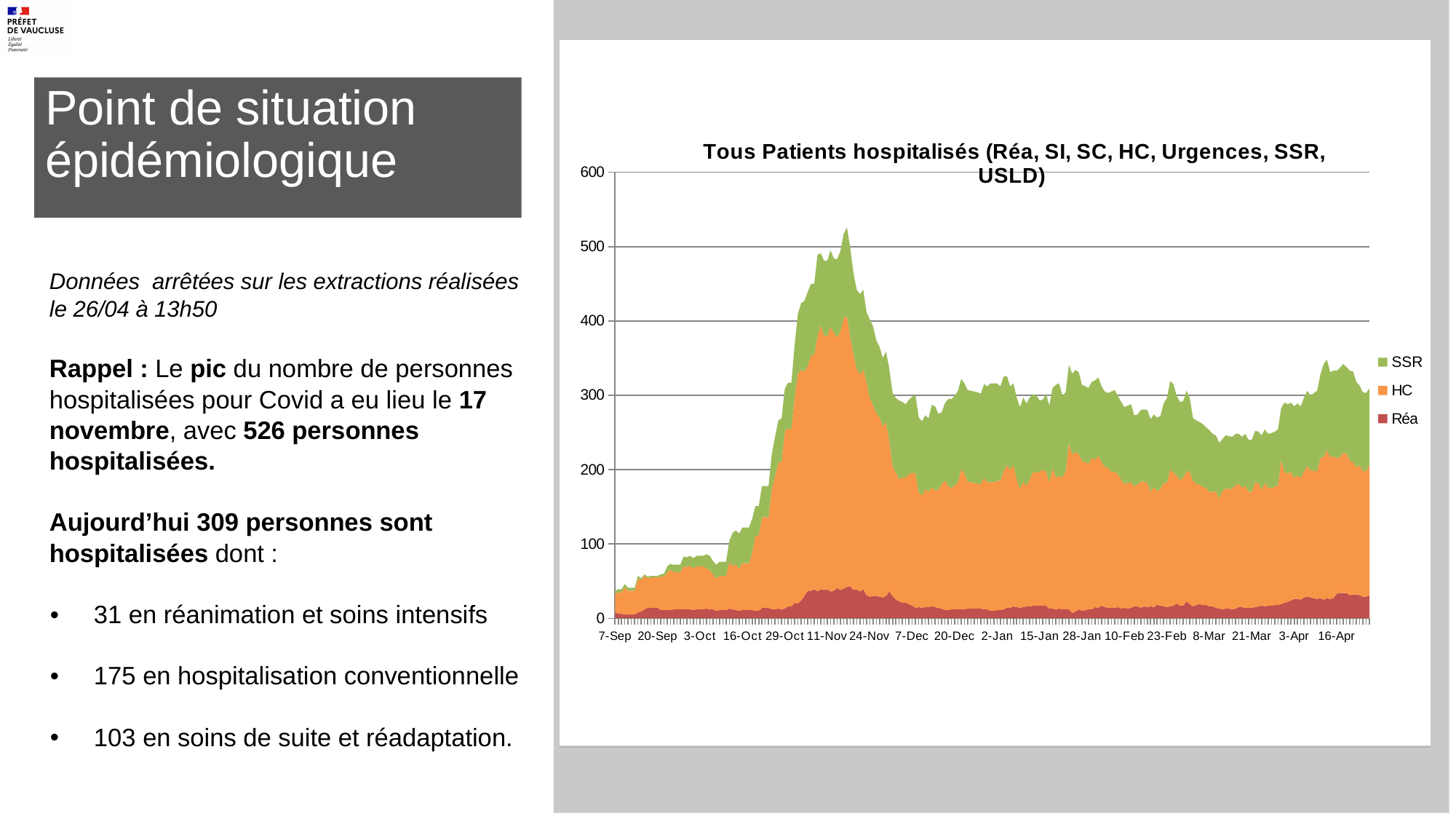
What kind of chart is shown on the slide? Stacked area chart What is the title of the chart? Tous Patients hospitalisés (Réa, SI, SC, HC, Urgences, SSR, USLD) Which series occupies the largest band of the stacked area over the whole period, HC or Réa? HC Do the total hospitalised values rise or fall between 7-Sep and 11-Nov? rise Is the total number of hospitalised patients on 7-Sep greater or less than 100? less What are the series names listed in the chart legend? SSR, HC, Réa Is the total number of hospitalised patients around 16-Apr greater or less than 300? greater Do the total hospitalised values rise or fall between 11-Nov and 7-Dec? fall Is the Réa value at its highest point in November greater or less than 100? less How many series does the chart legend list? 3 What is the highest value shown on the vertical axis? 600